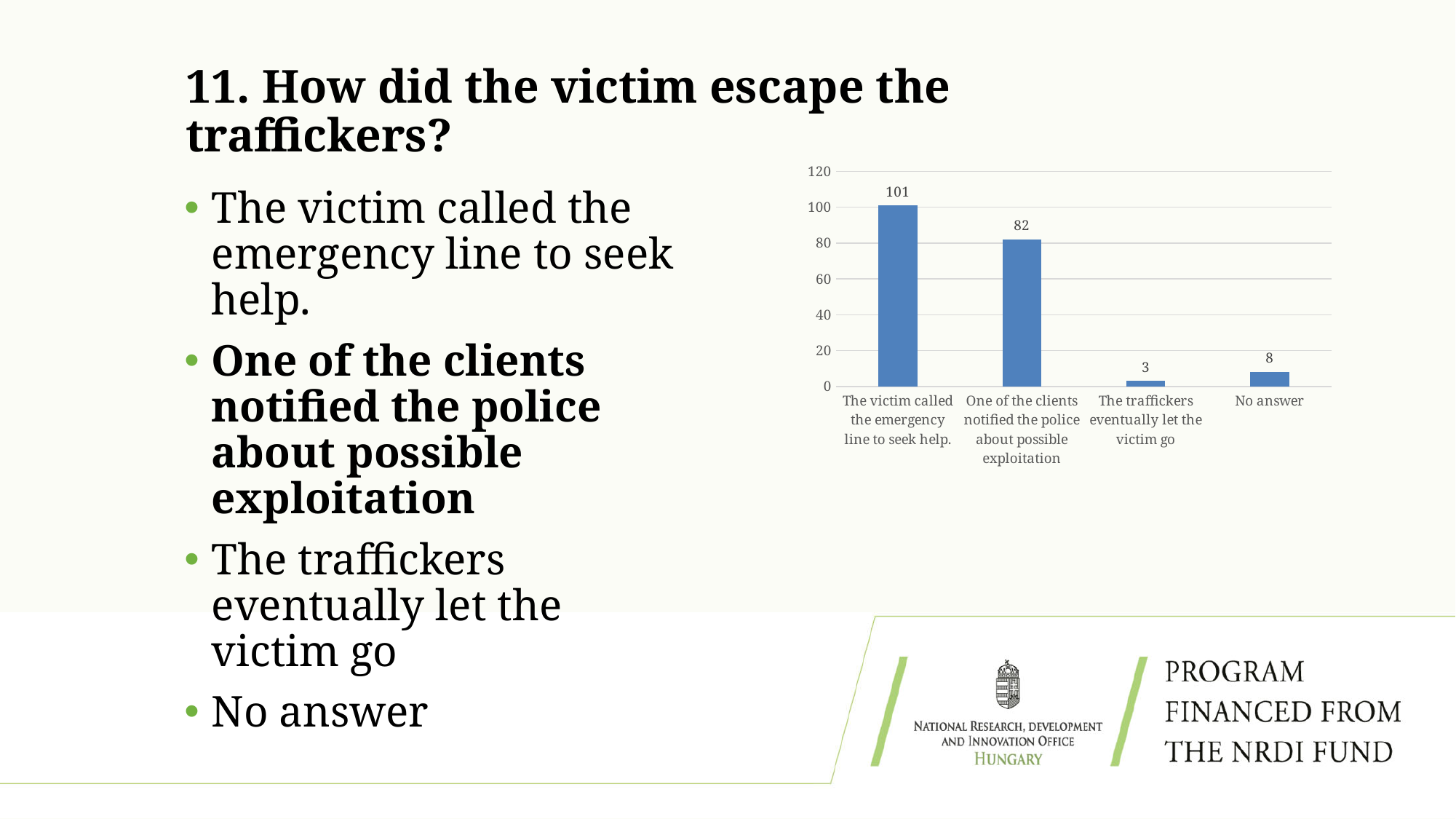
Which category has the lowest value? The traffickers eventually let the victim go What is the value for 'No answer'? 8 Which category has the highest value? The victim called the emergency line to seek help. What is the value for 'The victim called the emergency line to seek help.'? 101 What is the difference between the values for 'The victim called the emergency line to seek help.' and 'One of the clients notified the police about possible exploitation'? 19 What kind of chart is shown on the slide? bar chart How many categories are shown in the chart? 4 What is the value for 'The traffickers eventually let the victim go'? 3 Is the value for 'One of the clients notified the police about possible exploitation' greater or less than 100? less What is the highest value shown on the vertical axis? 120 What is the value for 'One of the clients notified the police about possible exploitation'? 82 Which is larger: the value for 'No answer' or the value for 'The traffickers eventually let the victim go'? No answer